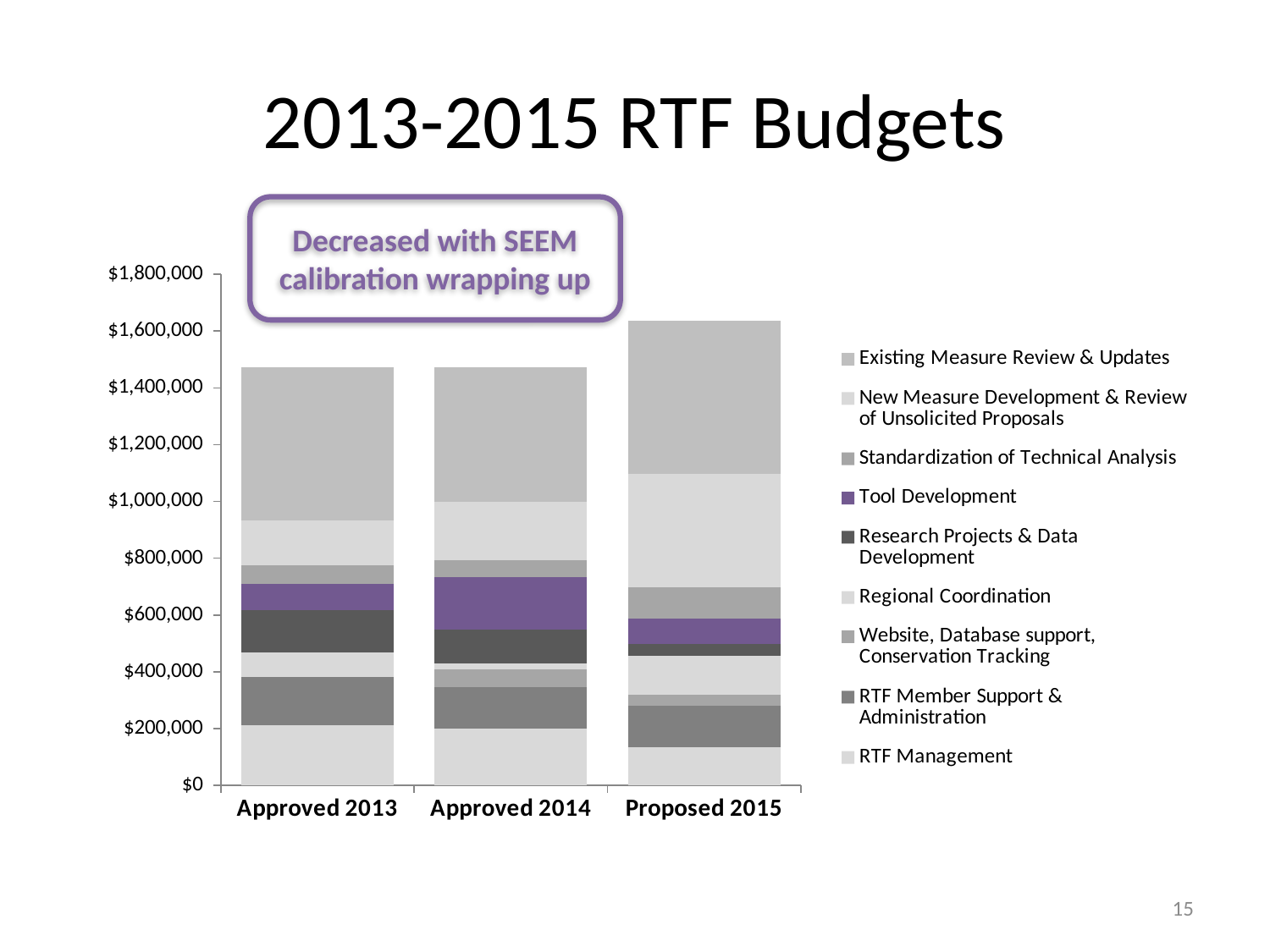
Is the total for Approved 2013 greater or less than $1,400,000? greater Which year has the larger Research Projects & Data Development segment, Approved 2013 or Proposed 2015? Approved 2013 Which year has the larger Tool Development segment, Approved 2013 or Approved 2014? Approved 2014 What does the callout box above the chart say? Decreased with SEEM calibration wrapping up Which budget year has the tallest stacked bar? Proposed 2015 What kind of chart is shown on the slide? Stacked bar chart Is the total for Approved 2014 greater or less than $1,600,000? less What is the title of the slide containing the chart? 2013-2015 RTF Budgets How many budget years (categories) are plotted on the x axis? 3 Which series is shown in purple in the legend? Tool Development How many series does the legend list? 9 Is the total for Proposed 2015 greater or less than $1,800,000? less